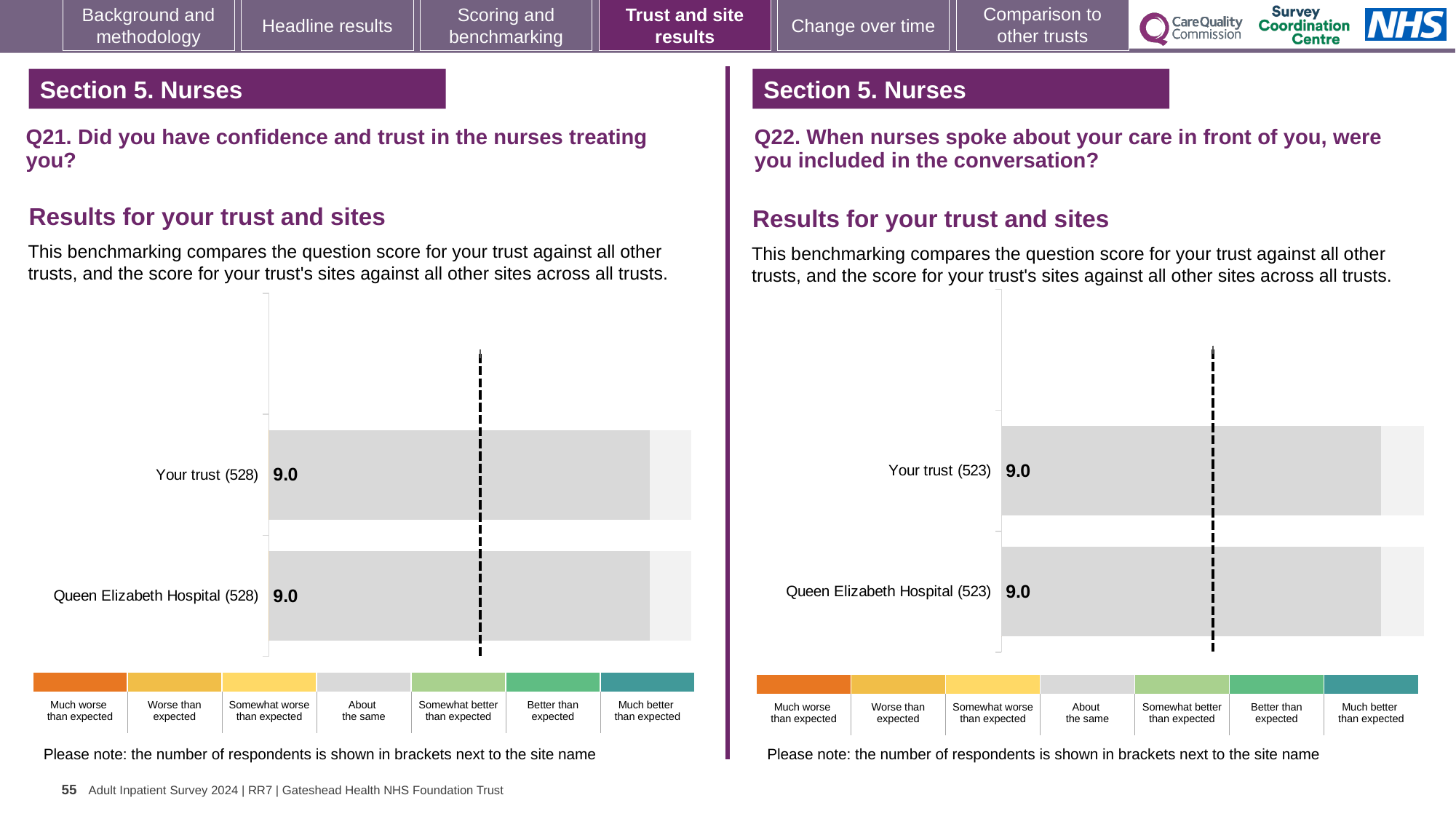
In the Q22 chart on the right, what is the score for Queen Elizabeth Hospital? 9.0 How many bars are plotted in the Q22 chart on the right? 2 What kind of chart is used for the Q21 results on the left? Bar chart How many bars are plotted in the Q21 chart on the left? 2 In the Q21 chart on the left, what is the score for Your trust? 9.0 In the Q22 chart on the right, how many respondents are shown in brackets next to Queen Elizabeth Hospital? 523 In the Q21 chart on the left, how many respondents are shown in brackets next to Your trust? 528 In the Q21 chart on the left, what is the difference between the score for Your trust and the score for Queen Elizabeth Hospital? 0.0 In the Q21 chart on the left, what is the score for Queen Elizabeth Hospital? 9.0 In the Q22 chart on the right, what is the score for Your trust? 9.0